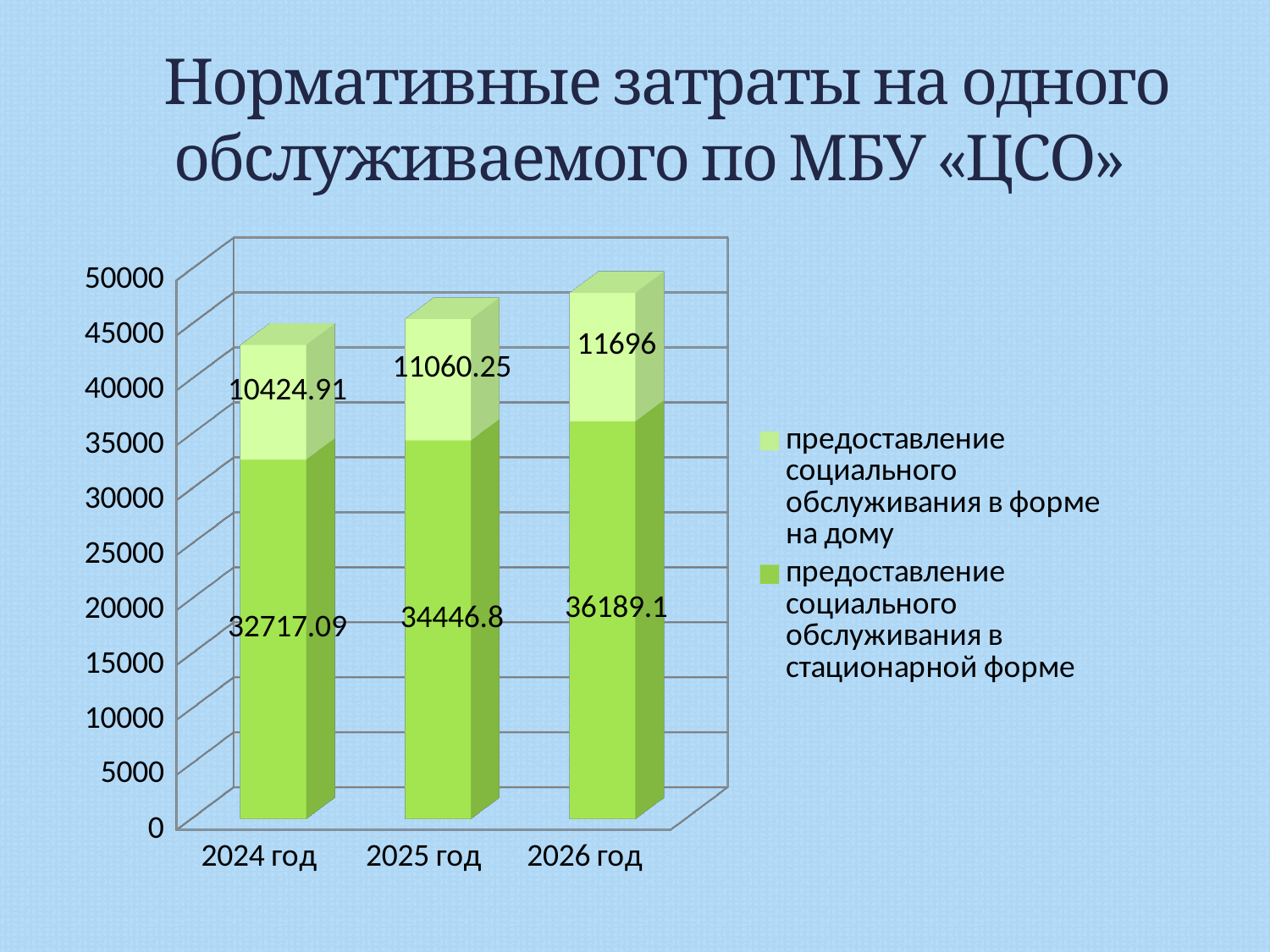
What is the value for 2025 год in the series 'предоставление социального обслуживания в форме на дому'? 11060.25 What is the value for 2026 год in the series 'предоставление социального обслуживания в форме на дому'? 11696 Which year has the lowest value for 'предоставление социального обслуживания в форме на дому'? 2024 год How many series does the legend list? 2 What is the total of the stacked bar for 2024 год? 43142 What is the value for 2024 год in the series 'предоставление социального обслуживания в стационарной форме'? 32717.09 What is the difference between the 2026 год and 2024 год values for 'предоставление социального обслуживания в стационарной форме'? 3472.01 Which is larger: the 2025 год value for 'предоставление социального обслуживания в стационарной форме' or the 2025 год value for 'предоставление социального обслуживания в форме на дому'? предоставление социального обслуживания в стационарной форме Do the values for 'предоставление социального обслуживания в стационарной форме' rise or fall from 2024 год to 2026 год? rise What is the total of the stacked bar for 2025 год? 45507.05 How many years are shown on the x axis? 3 Which year has the highest value for 'предоставление социального обслуживания в стационарной форме'? 2026 год